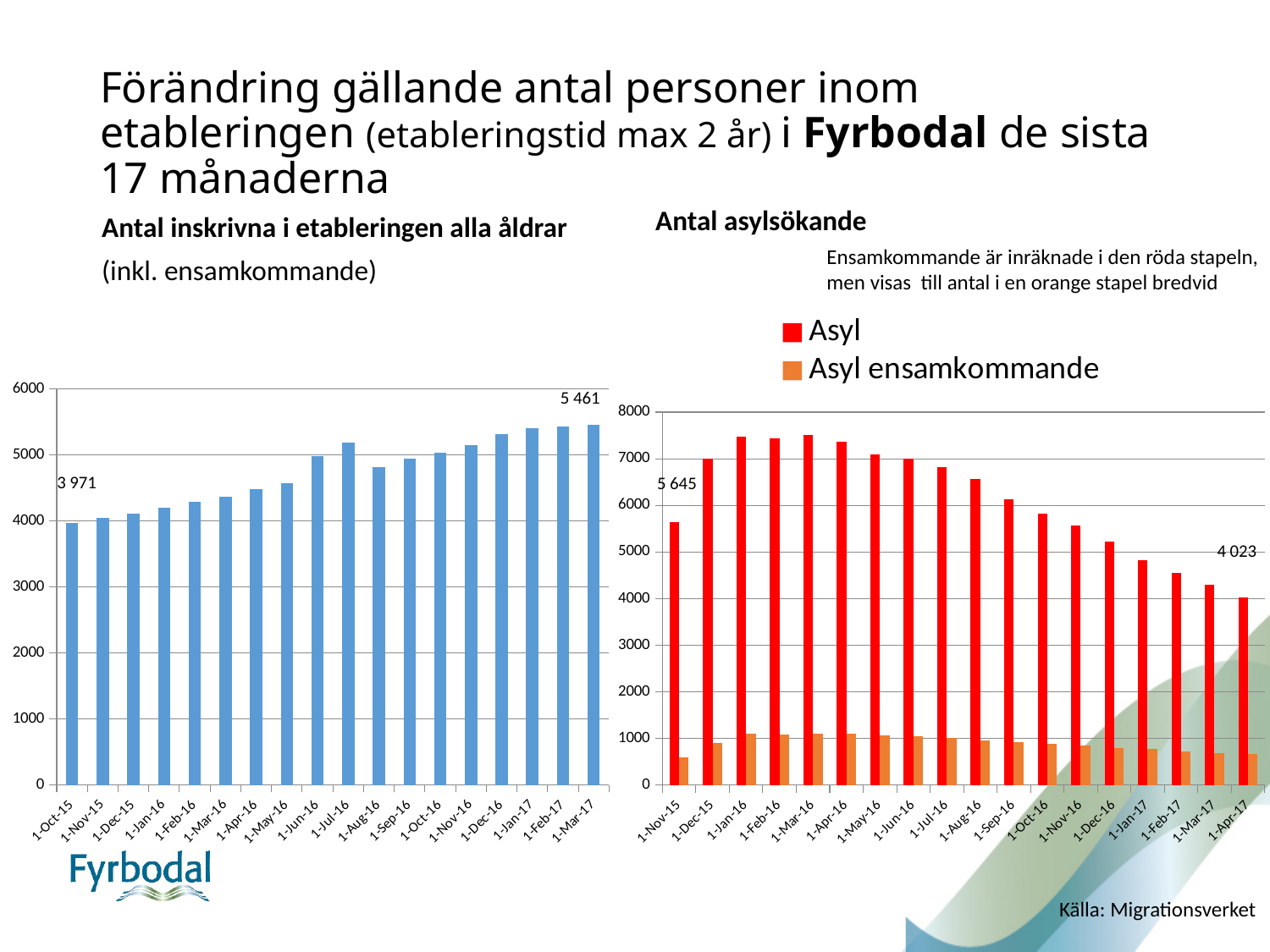
In the right chart (Antal asylsökande), is the Asyl ensamkommande value for 1-Nov-15 greater or less than 1000? less In the left chart (Antal inskrivna i etableringen alla åldrar), is the value for 1-Jul-16 greater or less than 5000? greater In the left chart (Antal inskrivna i etableringen alla åldrar), what is the difference between the values for 1-Mar-17 and 1-Oct-15? 1 490 In the right chart (Antal asylsökande), which month has the lowest Asyl value? 1-Apr-17 In the left chart (Antal inskrivna i etableringen alla åldrar), what is the value for 1-Mar-17? 5 461 In the right chart (Antal asylsökande), what is the Asyl value for 1-Nov-15? 5 645 In the right chart (Antal asylsökande), what is the Asyl value for 1-Apr-17? 4 023 In the right chart (Antal asylsökande), what is the difference between the Asyl values for 1-Nov-15 and 1-Apr-17? 1 622 In the left chart (Antal inskrivna i etableringen alla åldrar), how many months are shown on the x axis? 18 In the left chart (Antal inskrivna i etableringen alla åldrar), do the values generally rise or fall from 1-Oct-15 to 1-Mar-17? rise In the left chart (Antal inskrivna i etableringen alla åldrar), what is the value for 1-Oct-15? 3 971 In the right chart (Antal asylsökande), how many series does the legend list? 2